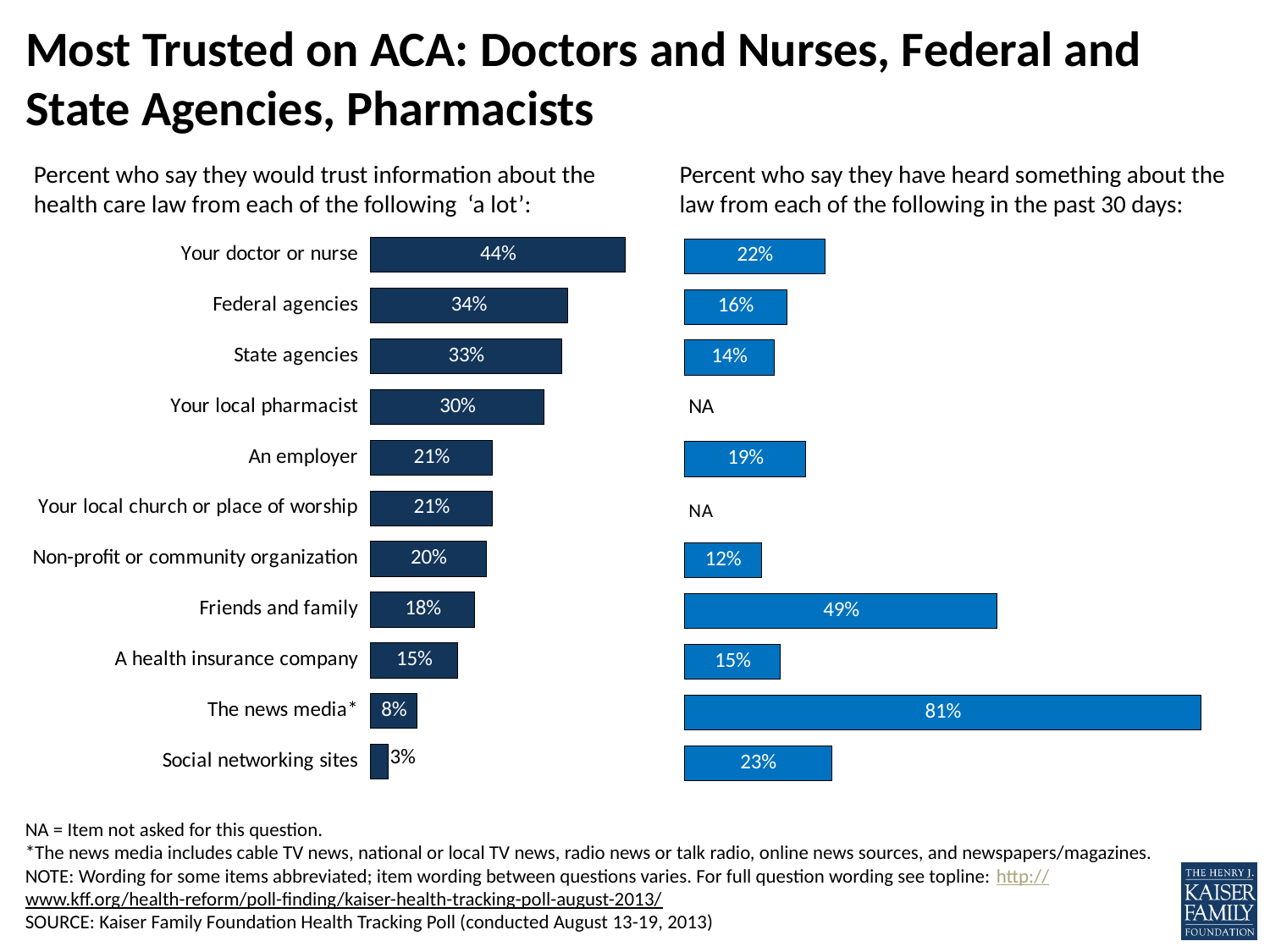
In the right chart (percent who have heard something in the past 30 days), which category has the highest value? The news media In the left chart (percent who would trust information 'a lot'), what is the value for A health insurance company? 15% How many categories are listed in the left chart (percent who would trust information 'a lot')? 11 In the right chart (percent who have heard something in the past 30 days), what is the value for The news media? 81% In the left chart (percent who would trust information 'a lot'), which is larger: Your local pharmacist or An employer? Your local pharmacist In the left chart (percent who would trust information 'a lot'), which category has the lowest value? Social networking sites In the left chart (percent who would trust information 'a lot'), what is the value for Your doctor or nurse? 44% What kind of chart is used on this slide? Bar chart In the right chart (percent who have heard something in the past 30 days), which categories are marked NA? Your local pharmacist and Your local church or place of worship In the left chart (percent who would trust information 'a lot'), what is the difference between Federal agencies and State agencies? 1% In the right chart (percent who have heard something in the past 30 days), which is larger: Your doctor or nurse or Federal agencies? Your doctor or nurse In the right chart (percent who have heard something in the past 30 days), what is the difference between Friends and family and Social networking sites? 26%